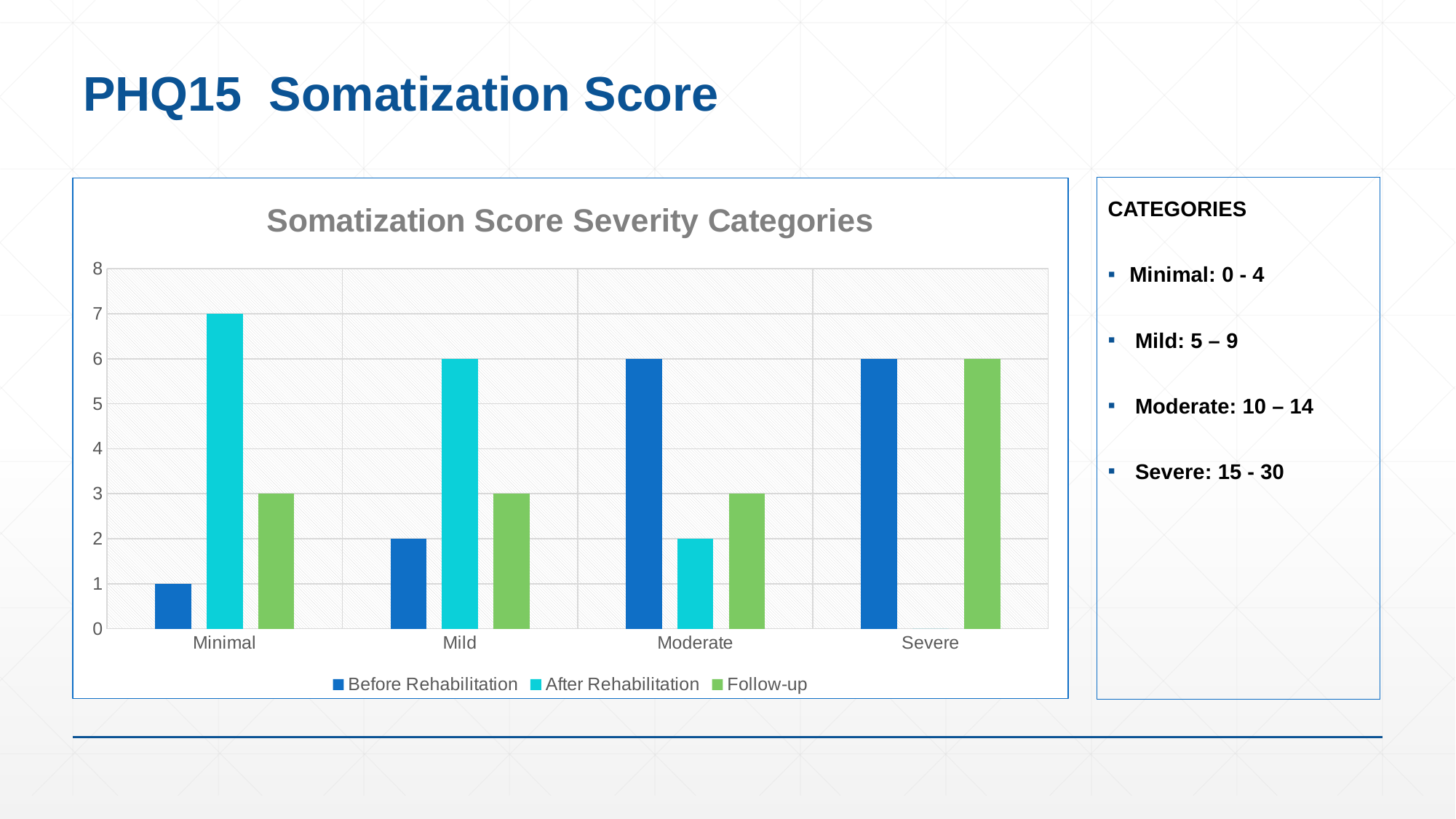
Which category has the lowest Before Rehabilitation value? Minimal Which category has the highest After Rehabilitation value? Minimal What is the After Rehabilitation value for the Minimal category? 7 Which is larger for the Moderate category, Before Rehabilitation or After Rehabilitation? Before Rehabilitation How many series does the legend list? 3 What is the Follow-up value for the Severe category? 6 What is the difference between the After Rehabilitation and Before Rehabilitation values for the Minimal category? 6 Is the After Rehabilitation value for the Mild category greater or less than 4? greater What is the title of the chart? Somatization Score Severity Categories How many severity categories are shown on the x axis? 4 What type of chart is shown on the slide? bar chart What is the Before Rehabilitation value for the Moderate category? 6